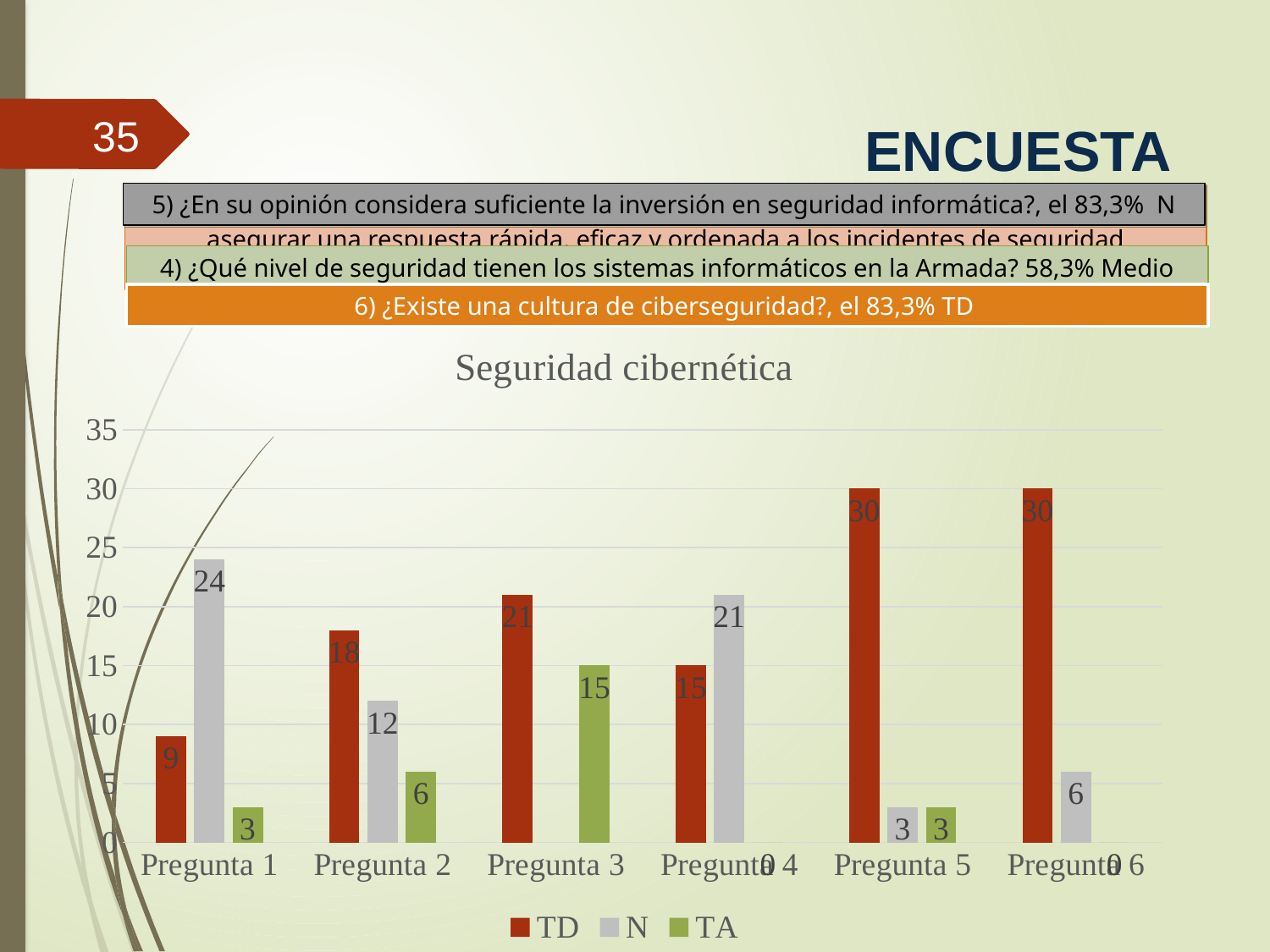
Which series is shown in red in the 'Seguridad cibernética' chart? TD Which pregunta has the lowest TD value? Pregunta 1 How many series does the legend of the 'Seguridad cibernética' chart list? 3 What is the value of TD for Pregunta 3? 21 How many categories (preguntas) are shown on the x axis of the 'Seguridad cibernética' chart? 6 Which pregunta has the highest N value? Pregunta 1 What is the value of TA for Pregunta 2? 6 For Pregunta 4, which is larger, TD or N? N What is the value of N for Pregunta 1? 24 What type of chart is shown under the title 'Seguridad cibernética'? bar chart Is the TD value for Pregunta 5 greater or less than 25? greater What is the difference between the TD value and the N value for Pregunta 2? 6